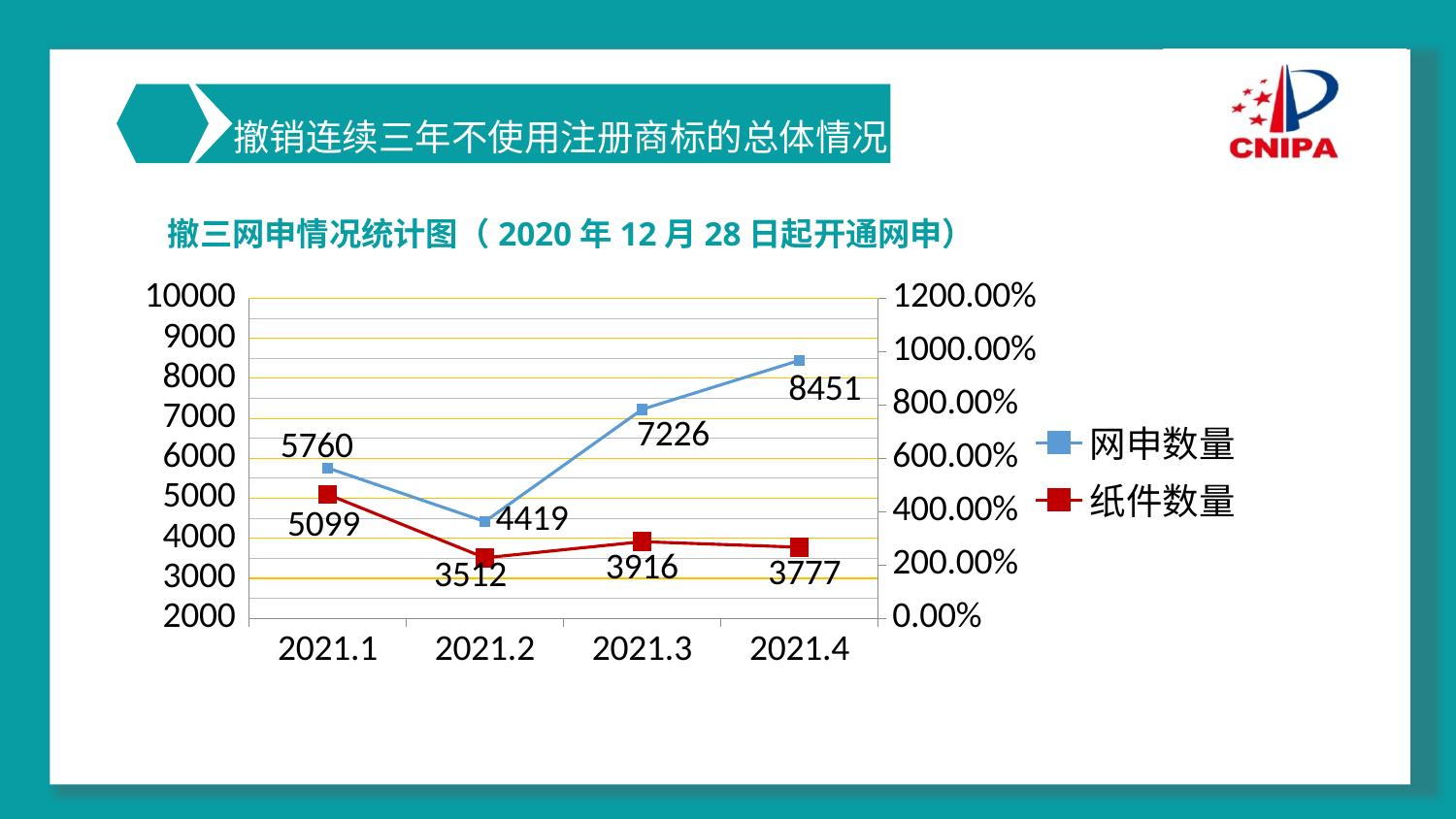
Which is larger in 2021.1, 网申数量 or 纸件数量? 网申数量 What is the value of 纸件数量 for 2021.2? 3512 In which period is 网申数量 highest? 2021.4 What type of chart is shown on the slide? line chart What is the value of 网申数量 for 2021.3? 7226 What is the difference between 网申数量 and 纸件数量 in 2021.4? 4674 What colour is the line for 纸件数量? red What is the value of 网申数量 for 2021.1? 5760 How many series does the legend list? 2 Does 网申数量 rise or fall from 2021.2 to 2021.4? rise In which period is 纸件数量 lowest? 2021.2 How many points are plotted along the x axis for each series? 4